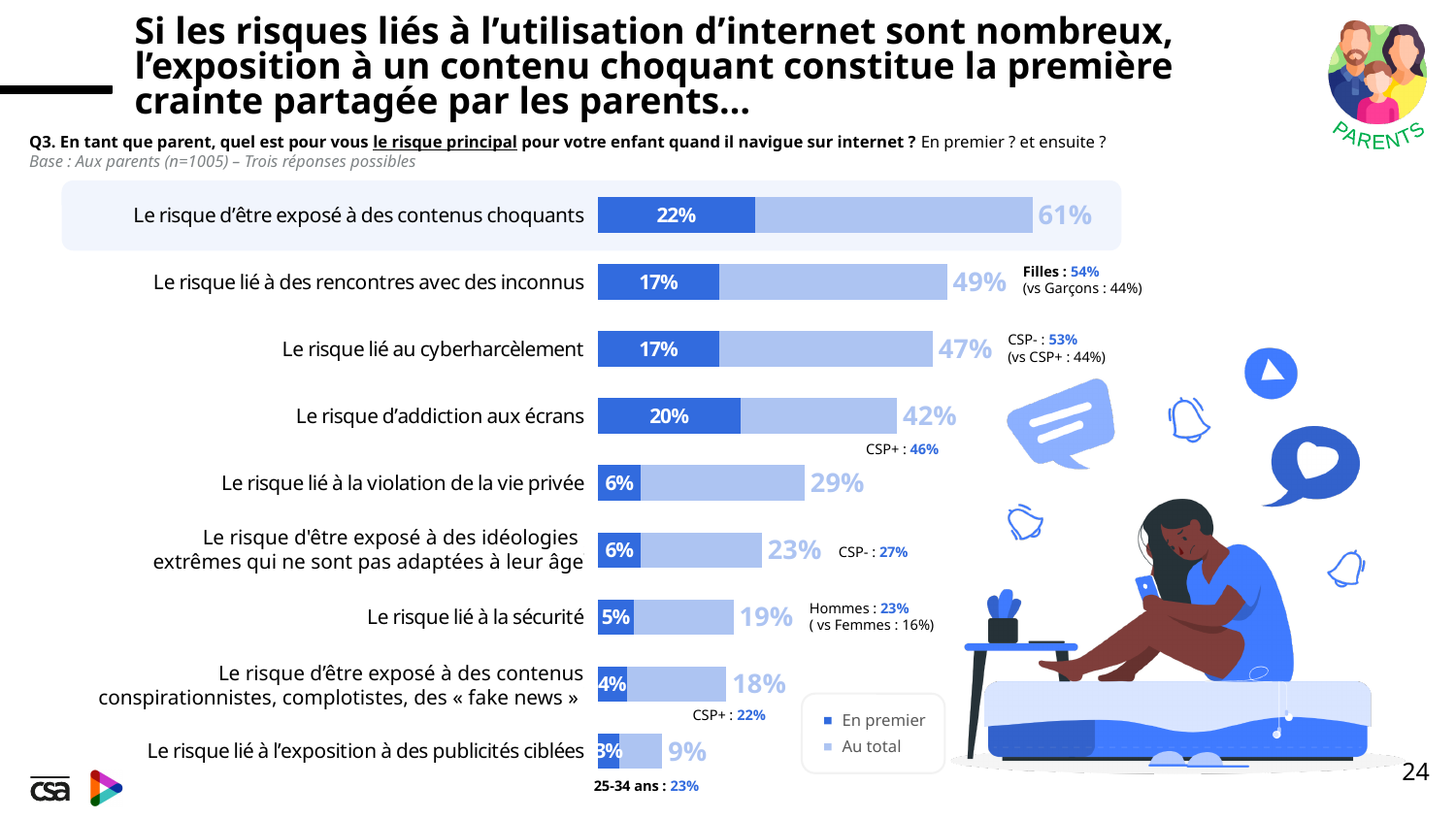
What are the two series named in the legend? En premier and Au total Which is larger: the 'En premier' value for 'Le risque d'addiction aux écrans' or for 'Le risque lié au cyberharcèlement'? Le risque d'addiction aux écrans How many series does the legend list? 2 What is the 'Au total' value for 'Le risque lié à la violation de la vie privée'? 29% How many categories are shown in the chart? 9 What kind of chart is shown on the slide? Bar chart What is the 'Au total' value for 'Le risque d'être exposé à des contenus choquants'? 61% What is the difference between the 'Au total' values for 'Le risque lié à des rencontres avec des inconnus' and 'Le risque lié au cyberharcèlement'? 2% Which category has the lowest 'Au total' value? Le risque lié à l'exposition à des publicités ciblées What is the 'Au total' value for 'Le risque lié au cyberharcèlement'? 47% What is the 'En premier' value for 'Le risque d'addiction aux écrans'? 20% Which category has the highest 'Au total' value? Le risque d'être exposé à des contenus choquants